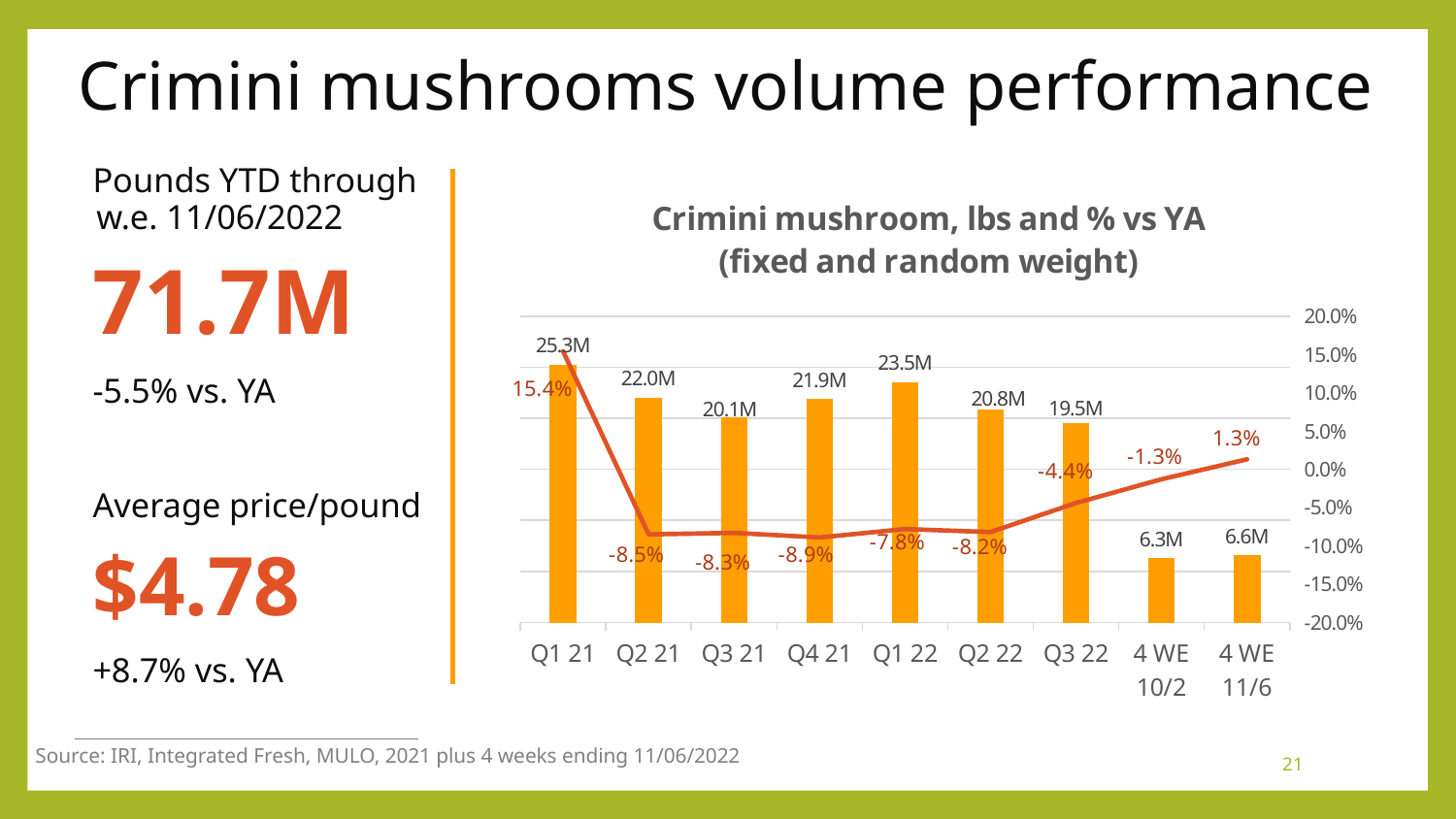
What is the difference in pounds between Q1 21 and Q2 21? 3.3M Does the % vs YA line rise or fall from Q3 22 to 4 WE 11/6? Rise What is the % vs YA value for Q1 21? 15.4% How many periods are shown on the x axis? 9 Which period has the lowest % vs YA value? Q4 21 What is the volume in pounds for the 4 WE 11/6 period? 6.6M Which is larger, the volume for Q4 21 or Q3 21? Q4 21 What is the % vs YA value for Q3 22? -4.4% Which period has the highest volume in pounds? Q1 21 What is the title of the chart? Crimini mushroom, lbs and % vs YA (fixed and random weight) What kind of chart is this? Combination bar and line chart What is the volume in pounds for Q1 22? 23.5M